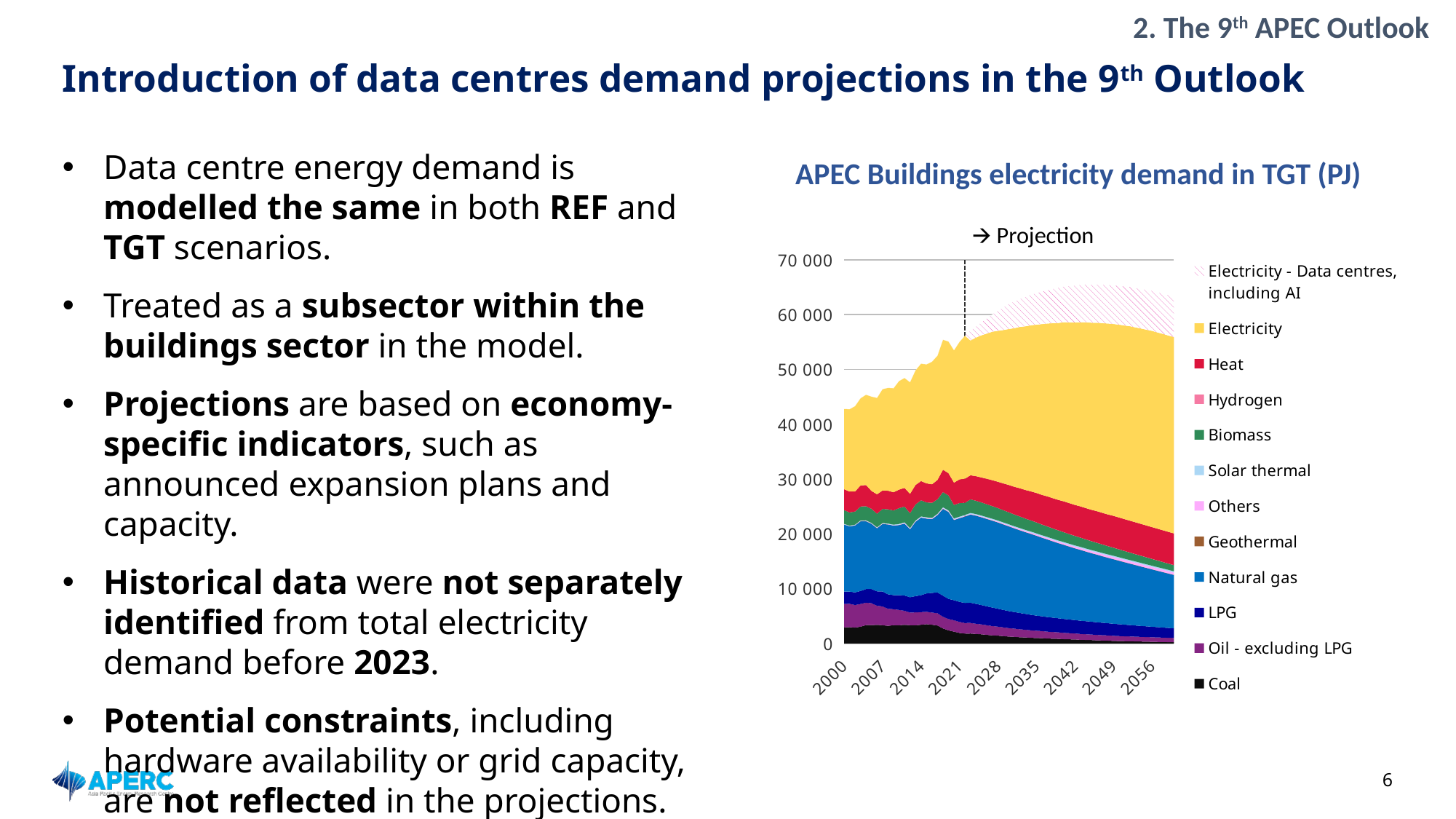
How many year labels are shown on the x axis? 9 What is the highest value shown on the y axis? 70 000 Is the total demand including data centres around 2042 greater or less than 60 000 PJ? greater Is the total buildings energy demand in 2000 greater or less than 40 000 PJ? greater What is the title of the chart? APEC Buildings electricity demand in TGT (PJ) Which legend entry is shown with a hatched pattern rather than a solid colour? Electricity - Data centres, including AI Is the value of the Coal series in 2000 greater or less than 10 000 PJ? less How many series does the legend of the chart list? 12 Does the Natural gas series rise or fall over the projection period after 2021? Fall What kind of chart is shown on the slide? Stacked area chart Does the Electricity series rise or fall between 2000 and 2021? Rise Which series is the largest contributor to buildings demand in 2056? Electricity